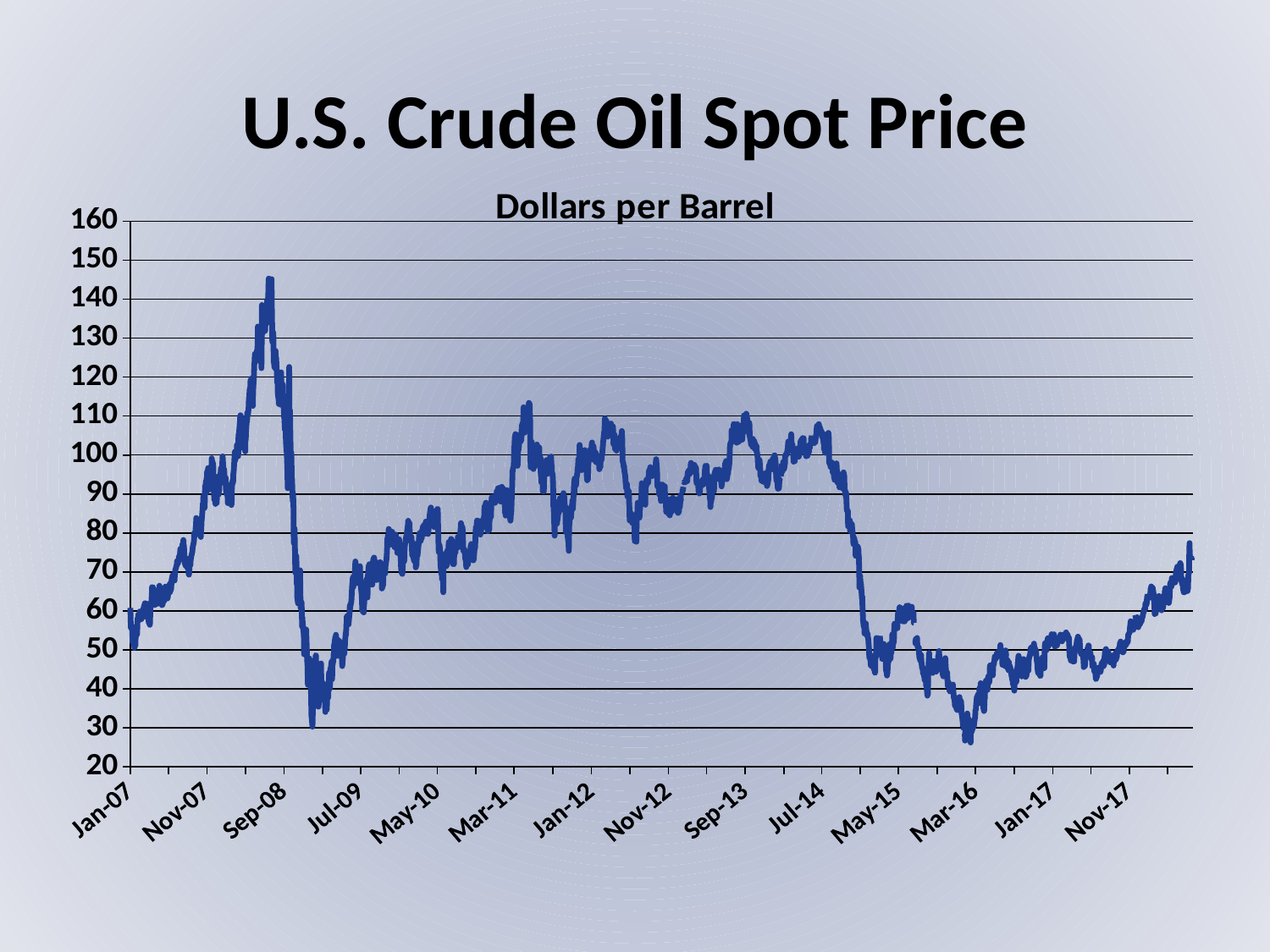
Is the peak value of the line in 2008 greater or less than 130? greater Is the value at Jan-07 greater or less than 40? greater Does the line rise or fall between Jul-14 and May-15? fall Is the value at Jul-14 greater or less than 90? greater What is the title of the chart? U.S. Crude Oil Spot Price What kind of chart is shown on the slide? line chart In which year does the line reach its highest value? 2008 How many date labels are shown along the x axis? 14 Does the line rise or fall between Jan-07 and Sep-08? rise What unit is the price measured in, according to the chart subtitle? Dollars per Barrel